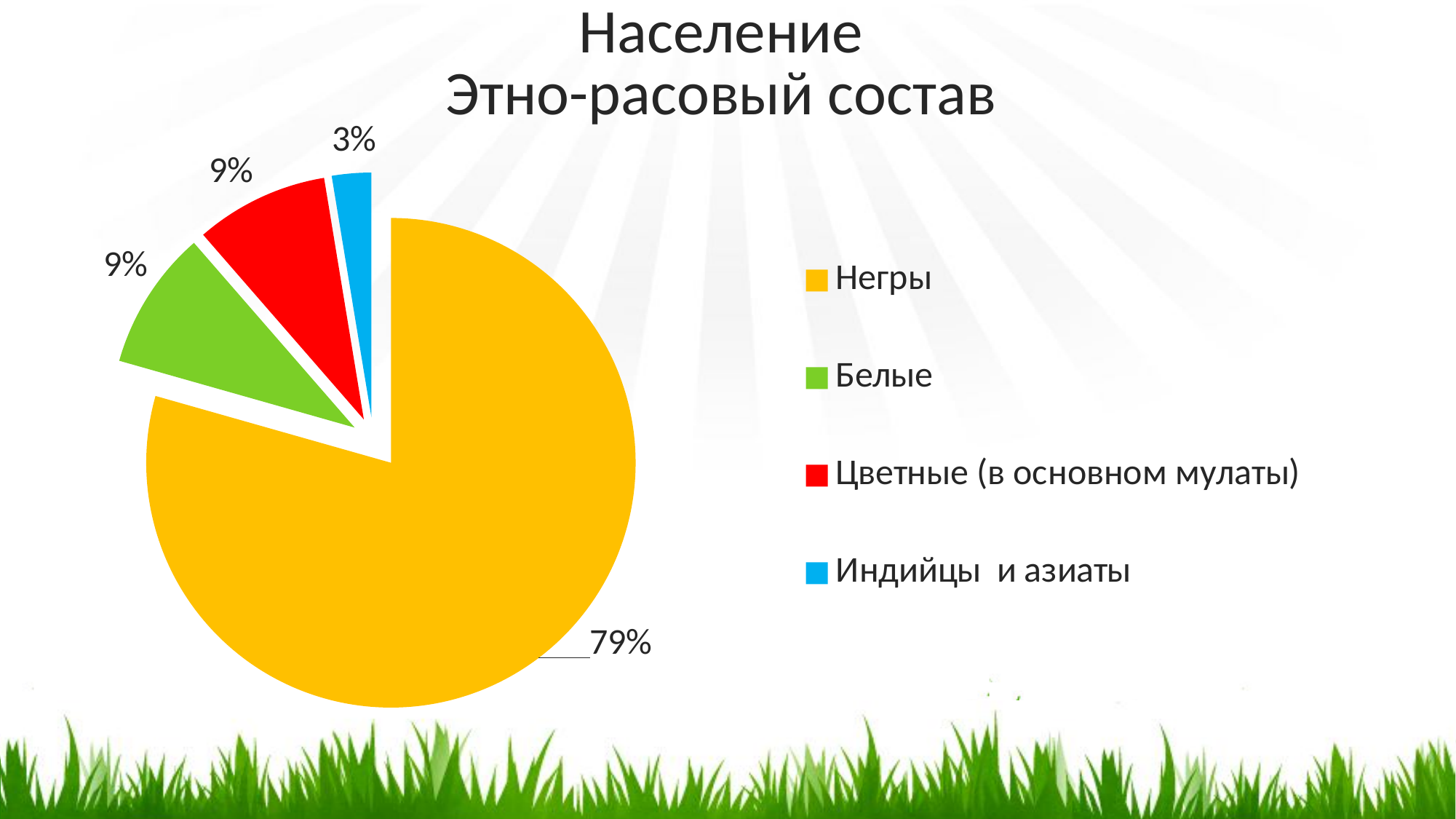
Which group has the largest slice of the pie? Негры What colour is the slice for Цветные (в основном мулаты)? Red What is the difference in percentage points between the Негры slice and the Индийцы и азиаты slice? 76 percentage points What share of the population is shown for Цветные (в основном мулаты)? 9% What share of the population is shown for Индийцы и азиаты? 3% Which group has the smallest slice of the pie? Индийцы и азиаты What share of the population is shown for Белые? 9% How many groups (slices) does the pie chart show? 4 Which is larger, the slice for Белые or the slice for Индийцы и азиаты? Белые What is the title of the chart? Население Этно-расовый состав What share of the population is shown for Негры? 79% What kind of chart is shown on the slide? Pie chart